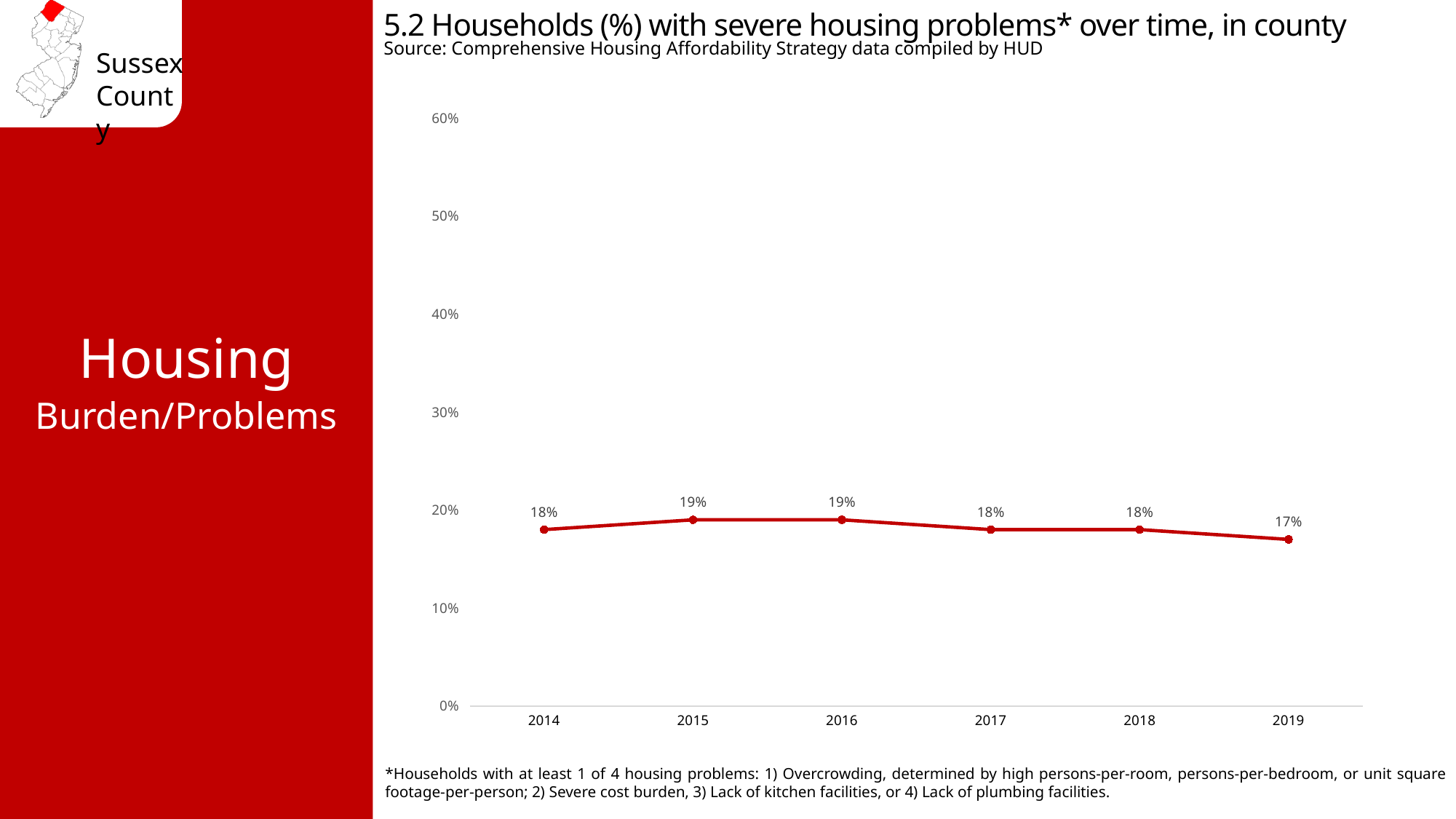
Is the value for 2017 larger or smaller than the value for 2016? smaller Is the value for 2018 greater or less than 20%? less How many years are plotted on the chart? 6 Which year has the lowest percentage of households with severe housing problems? 2019 What is the difference between the values for 2015 and 2019? 2% What is the value shown for 2016? 19% What is the title of the chart? 5.2 Households (%) with severe housing problems* over time, in county What is the highest value labelled on the vertical axis? 60% Do the values generally rise or fall from 2016 to 2019? fall What kind of chart is shown on the slide? line chart What percentage of households had severe housing problems in 2014? 18% What is the value shown for 2019? 17%